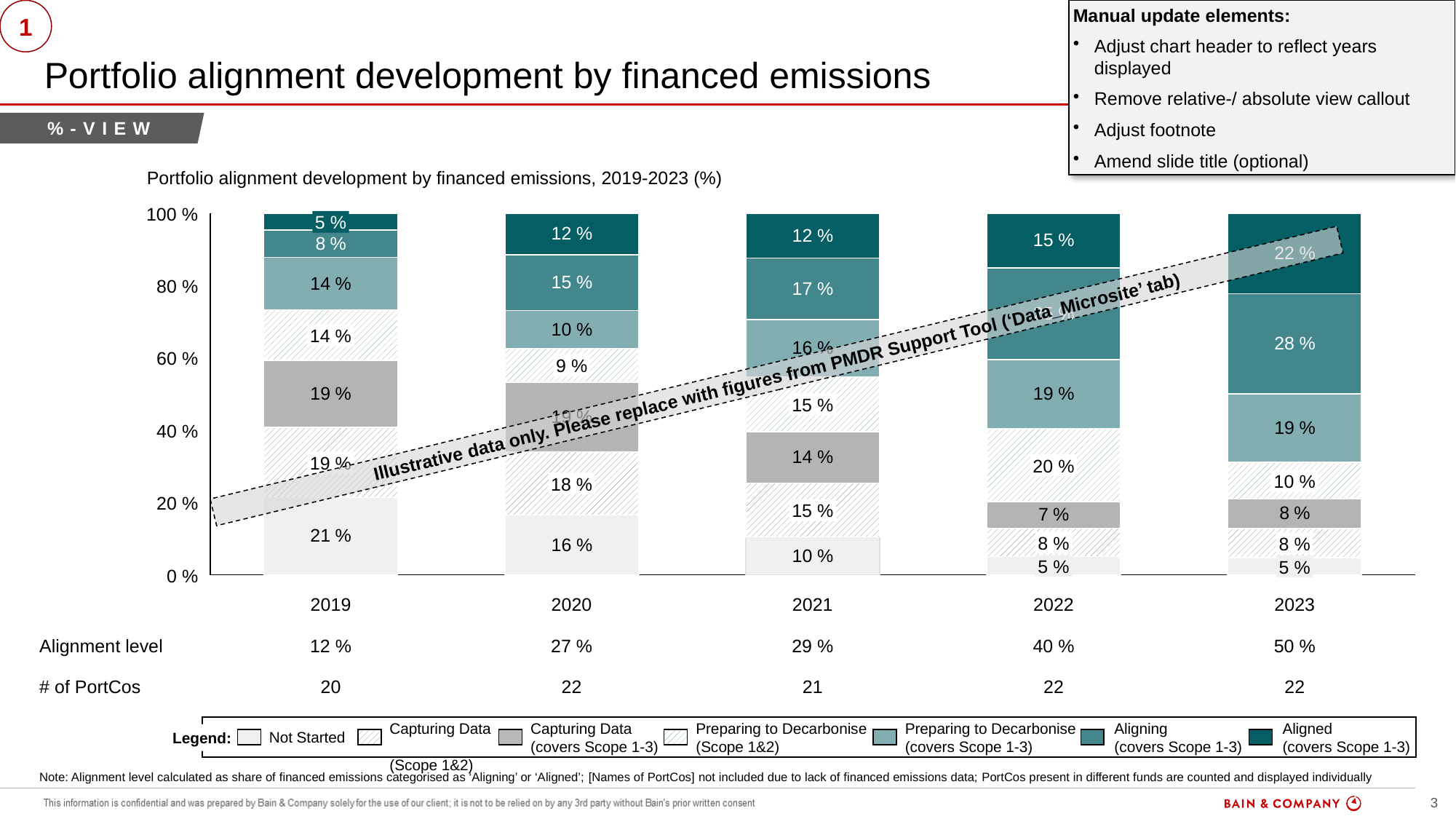
Which year has the larger 'Aligning (covers Scope 1-3)' share, 2021 or 2023? 2023 Does the 'Not Started' share rise or fall from 2019 to 2023? Fall How many years are shown on the x axis of the chart? 5 What is the share of 'Not Started' in 2019? 21 % In which year is the 'Aligned (covers Scope 1-3)' share the highest? 2023 What is the Alignment level shown for 2022? 40 % How many series does the legend list? 7 What kind of chart is shown on the slide? Stacked bar chart What is the share of 'Aligned (covers Scope 1-3)' in 2023? 22 % What is the share of 'Aligned (covers Scope 1-3)' in 2022? 15 % What is the chart's title? Portfolio alignment development by financed emissions, 2019-2023 (%) By how many percentage points is the 'Aligned (covers Scope 1-3)' share in 2023 higher than in 2019? 17 %